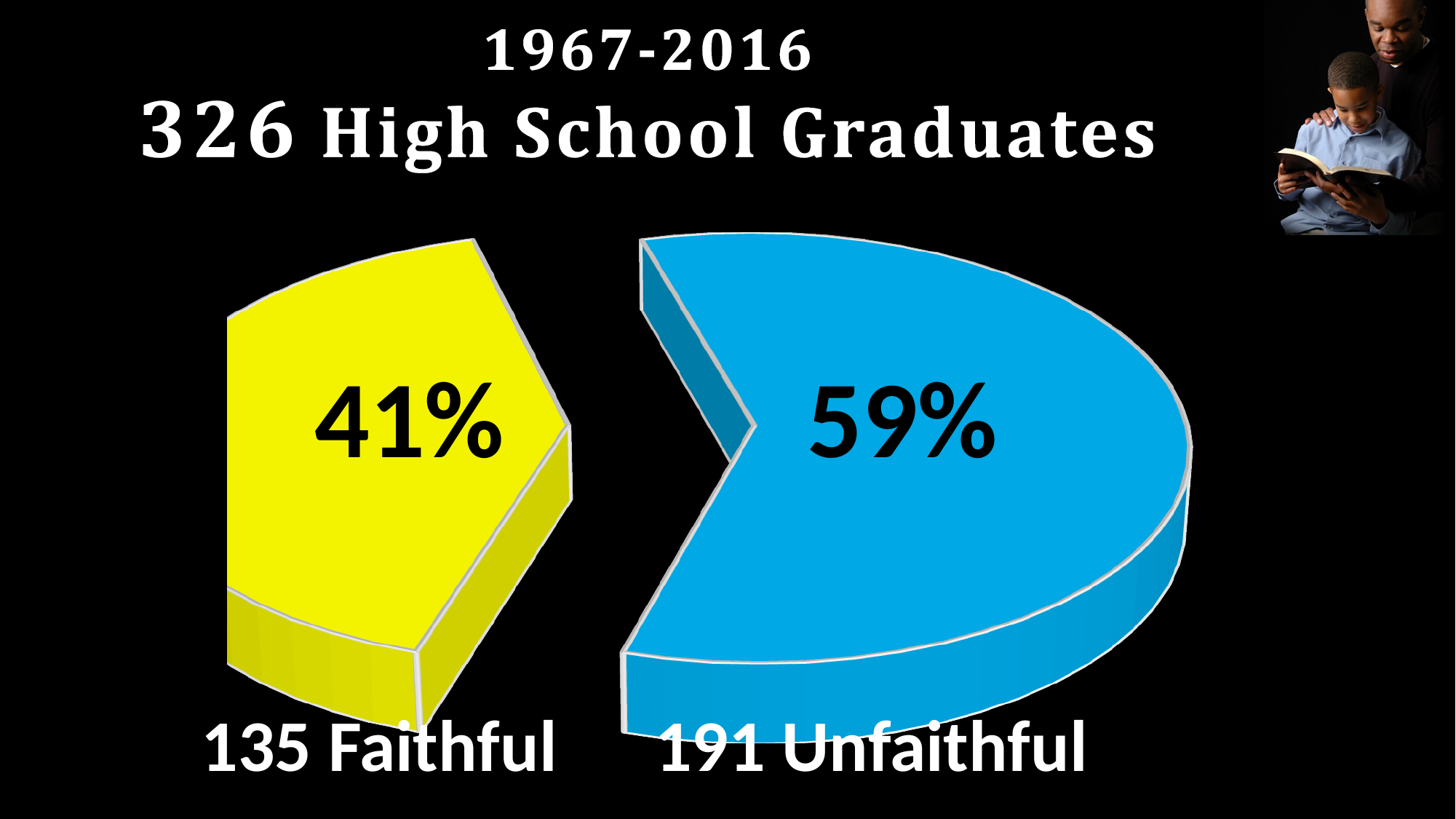
What is the difference between the Unfaithful count and the Faithful count? 56 Which slice of the pie is the smallest? Faithful What kind of chart is shown on the slide? pie chart What percentage of the pie is labelled Unfaithful? 59% How many slices does the pie chart have? 2 What percentage of the pie is labelled Faithful? 41% Which slice of the pie is the largest? Unfaithful Which is larger, the Faithful count or the Unfaithful count? Unfaithful What colour is the Faithful slice? yellow How many graduates are labelled Faithful? 135 How many graduates are labelled Unfaithful? 191 What is the difference in percentage points between the Unfaithful and Faithful slices? 18